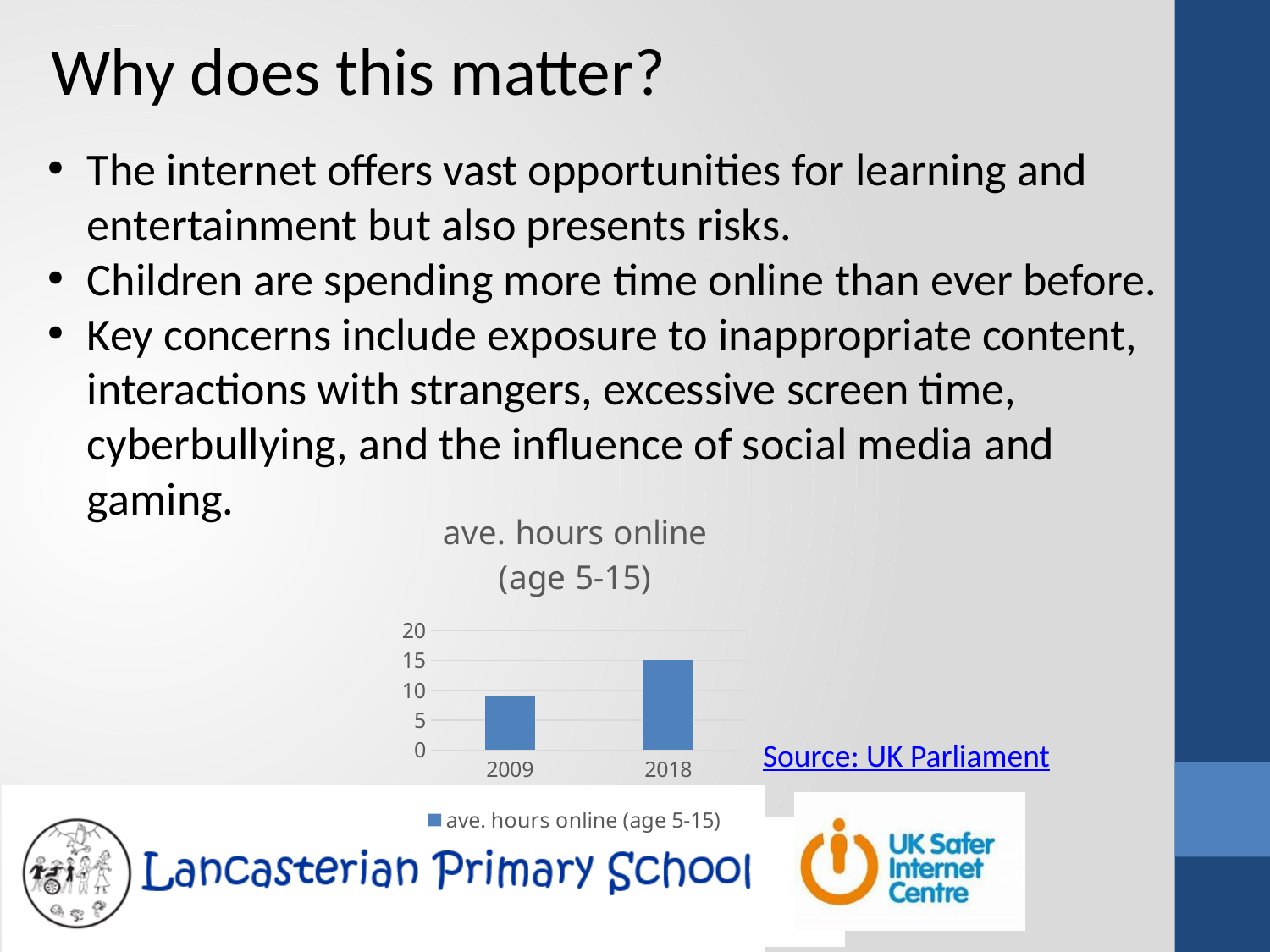
Is the value for 2009 greater or less than 10? less Is the value for 2018 greater or less than 20? less What is the title of the chart? ave. hours online (age 5-15) Is the value for 2009 greater or less than 5? greater Which year has the higher average hours online? 2018 What kind of chart is shown on the slide? bar chart Do the average hours online rise or fall from 2009 to 2018? rise Which year has the lower average hours online? 2009 How many series does the chart legend list? 1 How many categories are plotted on the x axis of the chart? 2 What is the highest value shown on the chart's vertical axis? 20